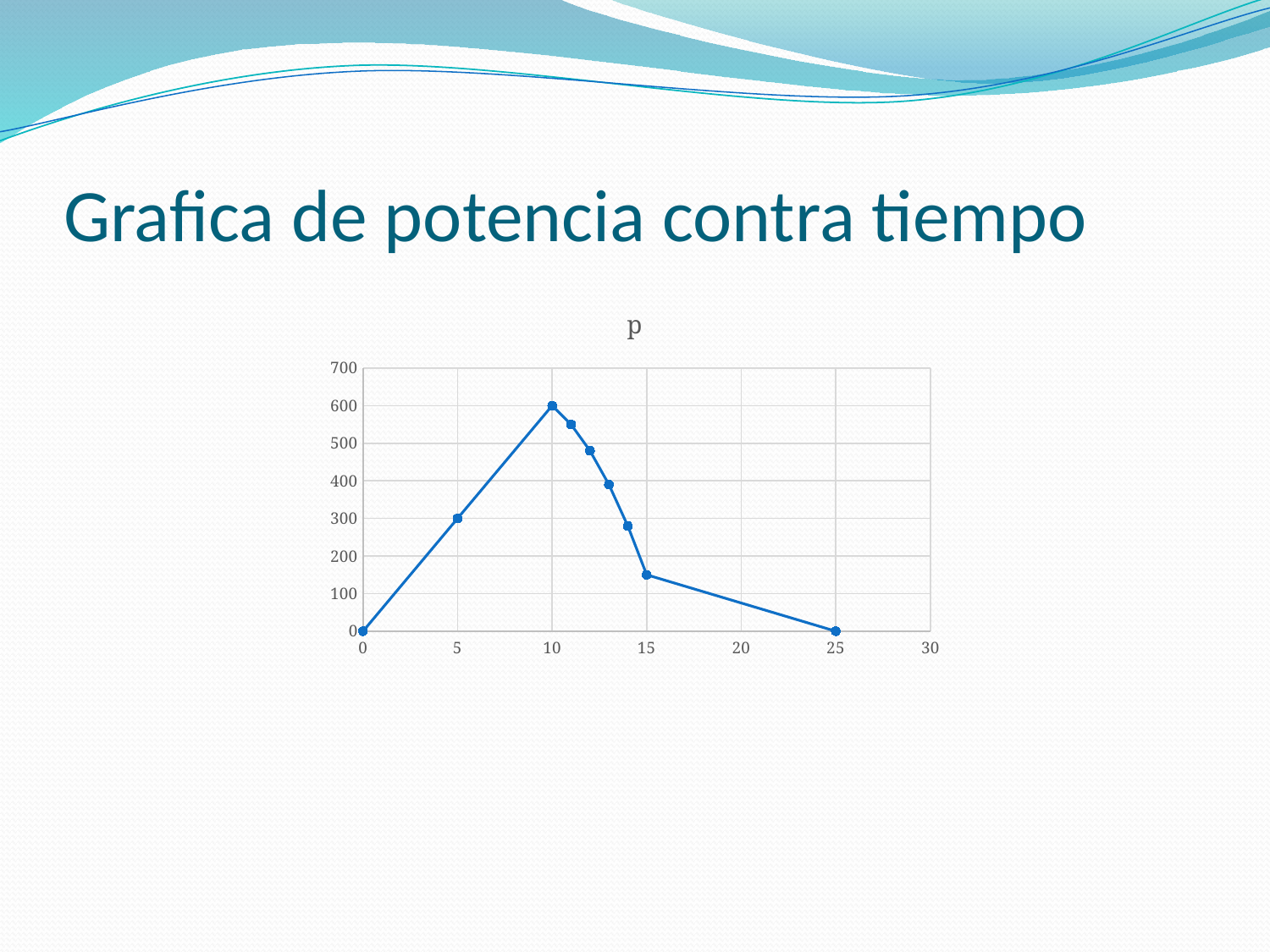
What is the value at x = 25? 0 What is the value at x = 10? 600 Is the value at x = 11 greater or less than 500? greater At which x value does the chart reach its highest point? 10 Which is larger, the value at x = 5 or the value at x = 15? x = 5 Is the value at x = 13 greater or less than 300? greater What is the value at x = 5? 300 What is the title of the chart? p How many data points are plotted on the chart? 9 What kind of chart is shown on the slide? line chart Do the values rise or fall along the x axis from x = 10 to x = 25? fall Is the value at x = 15 greater or less than 200? less